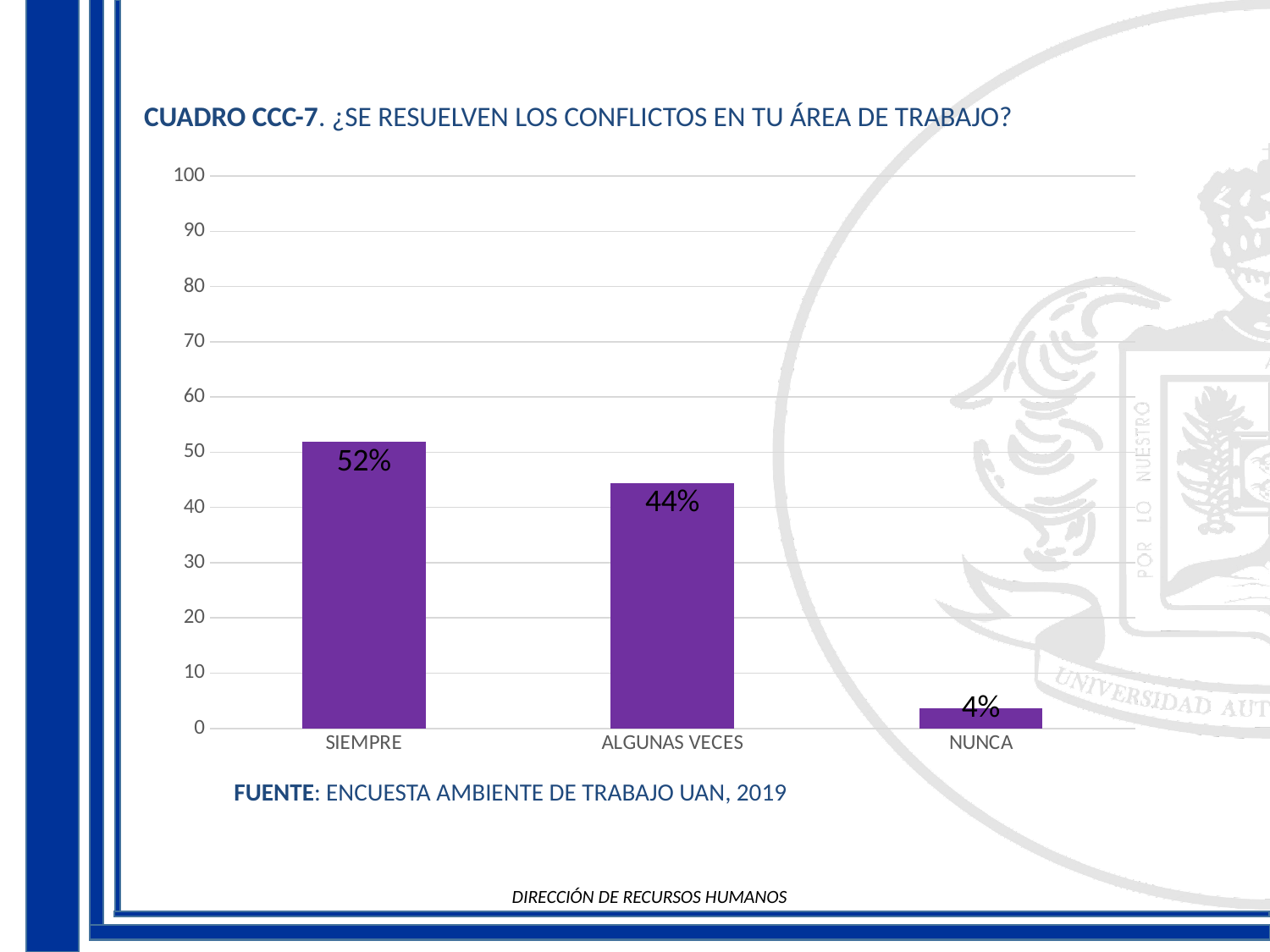
What is the value for SIEMPRE? 52% Which is larger, the value for SIEMPRE or the value for NUNCA? SIEMPRE What is the source cited below the chart? ENCUESTA AMBIENTE DE TRABAJO UAN, 2019 What is the value for ALGUNAS VECES? 44% What is the difference between the values for ALGUNAS VECES and NUNCA? 40% Which category has the lowest value? NUNCA What is the value for NUNCA? 4% What kind of chart is shown on the slide? bar chart Is the value for ALGUNAS VECES greater or less than 50? less How many categories are shown on the x axis? 3 Which category has the highest value? SIEMPRE What is the difference between the values for SIEMPRE and ALGUNAS VECES? 8%